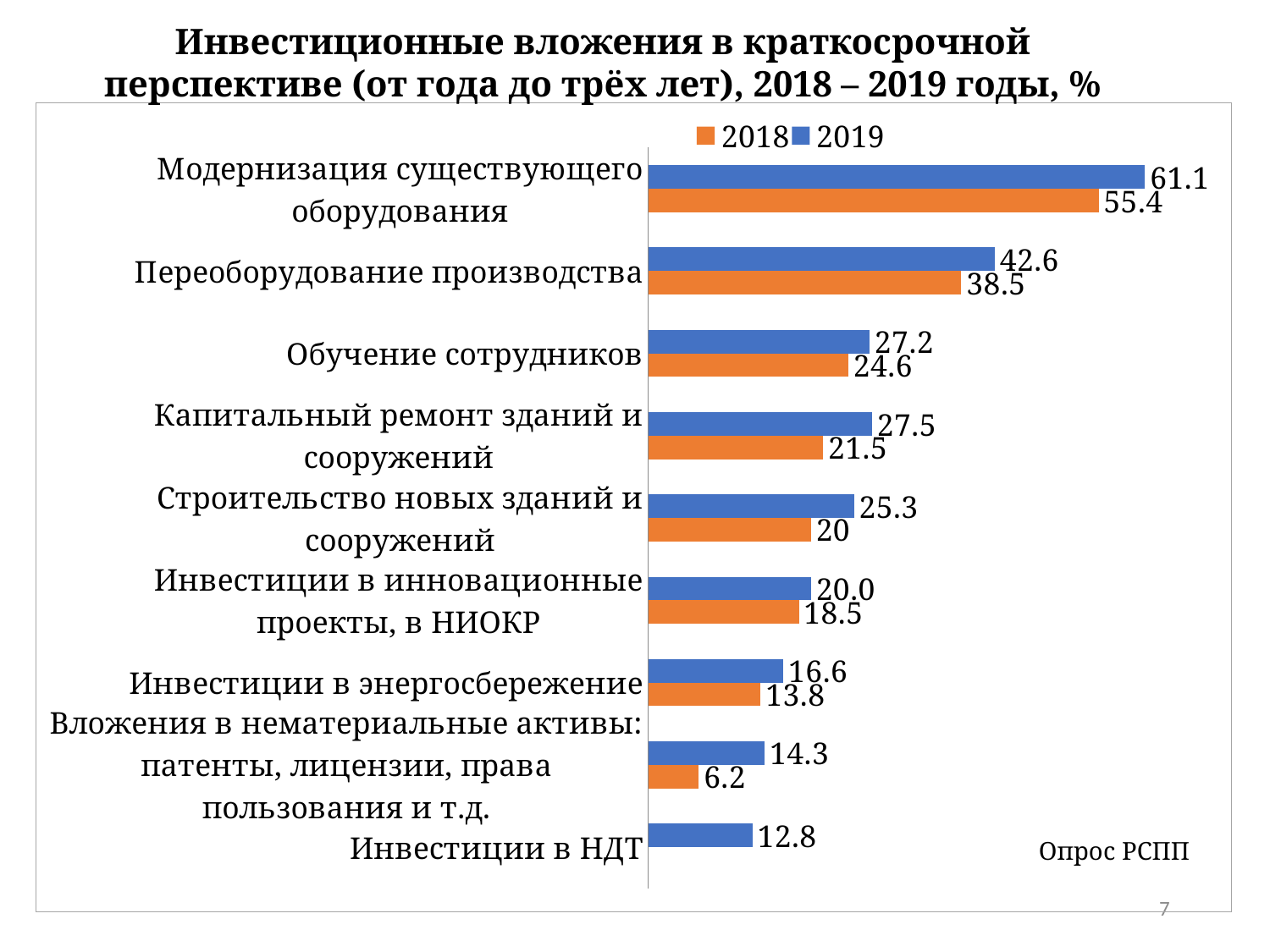
What is the 2018 value for «Вложения в нематериальные активы: патенты, лицензии, права пользования и т.д.»? 6.2 Which category has the highest 2019 value? Модернизация существующего оборудования What is the 2018 value for «Переоборудование производства»? 38.5 Which category has the lowest 2018 value? Вложения в нематериальные активы: патенты, лицензии, права пользования и т.д. What is the 2019 value for «Модернизация существующего оборудования»? 61.1 What is the 2019 value for «Инвестиции в НДТ»? 12.8 Which colour represents the 2018 series? Orange What kind of chart is shown on the slide? Bar chart How many series does the legend list? 2 What is the difference between the 2019 and 2018 values for «Капитальный ремонт зданий и сооружений»? 6 Which is larger for «Обучение сотрудников»: the 2018 value or the 2019 value? 2019 How many categories are shown on the chart? 9